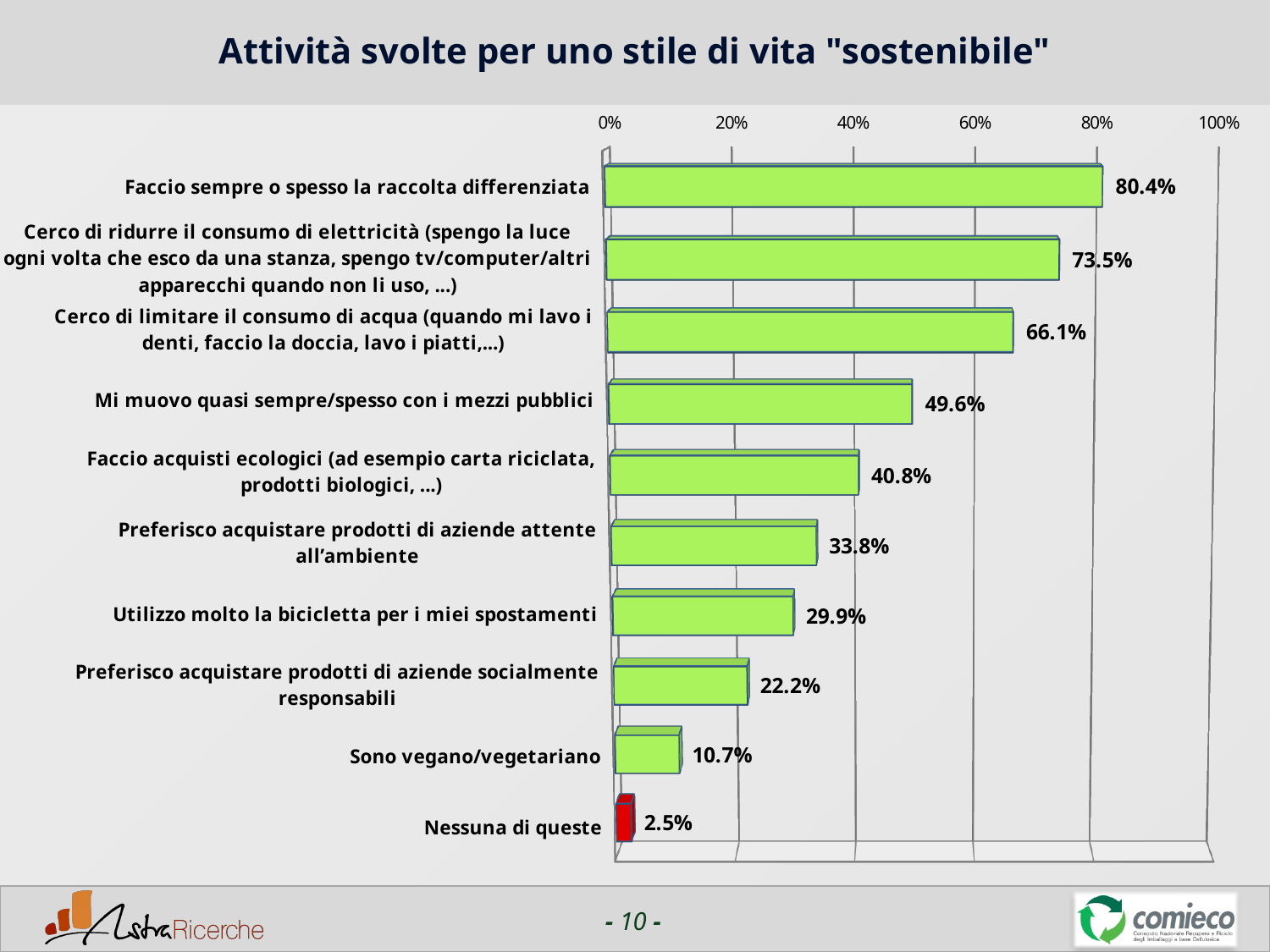
What kind of chart is shown on the slide? Bar chart Is the value for "Cerco di limitare il consumo di acqua" greater or less than 60%? greater Which category has the highest value? Faccio sempre o spesso la raccolta differenziata Which category has the lowest value? Nessuna di queste What is the value for "Mi muovo quasi sempre/spesso con i mezzi pubblici"? 49.6% Which bar is coloured red instead of green? Nessuna di queste What is the value for "Faccio sempre o spesso la raccolta differenziata"? 80.4% How many categories are shown in the chart? 10 Which is larger: "Faccio acquisti ecologici" or "Preferisco acquistare prodotti di aziende attente all'ambiente"? Faccio acquisti ecologici What is the value for "Sono vegano/vegetariano"? 10.7% What is the value for "Nessuna di queste"? 2.5% What is the difference between "Faccio sempre o spesso la raccolta differenziata" and "Utilizzo molto la bicicletta per i miei spostamenti"? 50.5%